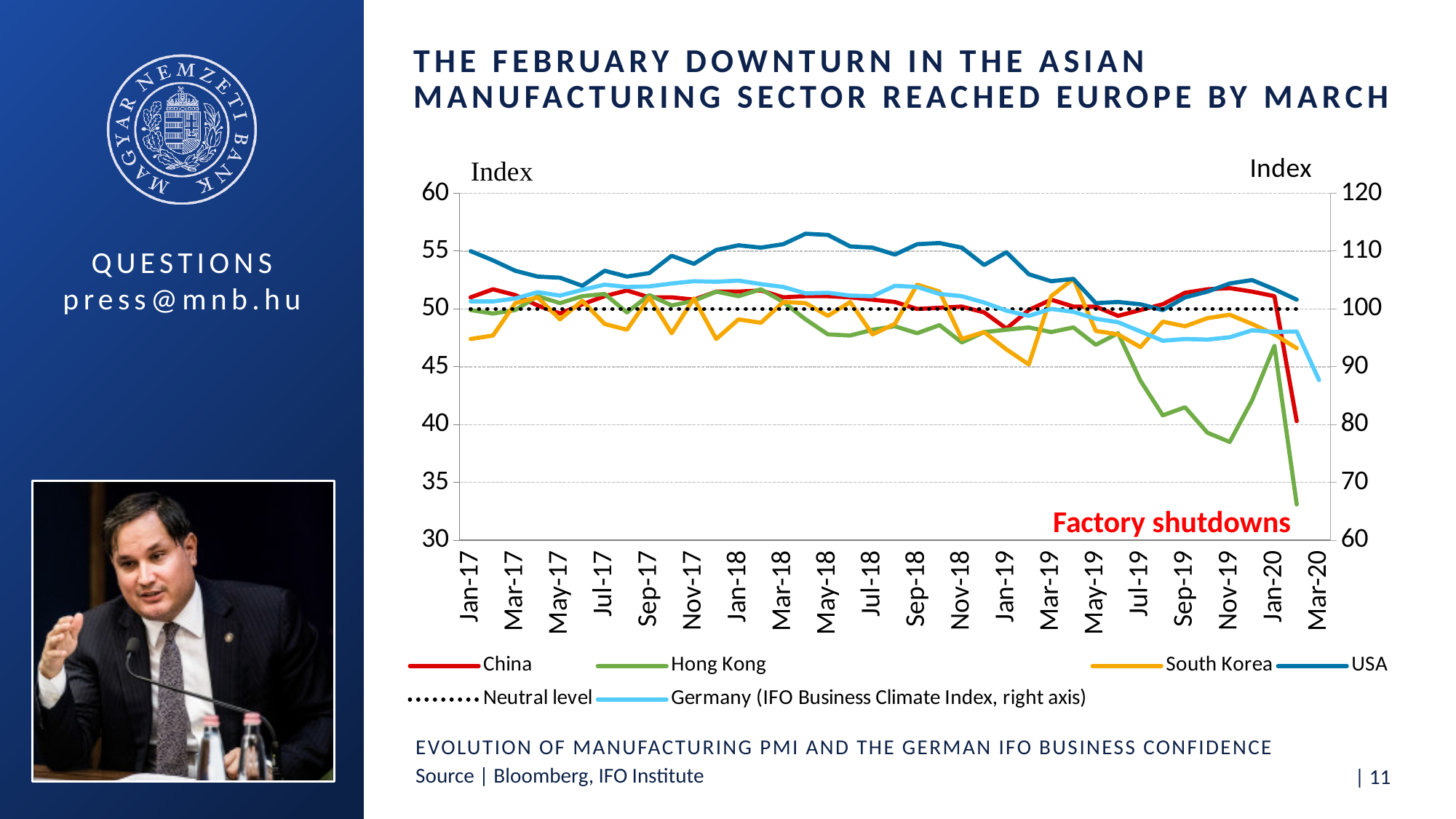
Is the value for South Korea in Jan-19 greater or less than 50? less How many series does the chart legend list? 6 Is the value for the USA in May-18 greater or less than 55? greater What kind of chart is shown on the slide? line chart Does the Hong Kong line rise or fall between Sep-18 and Nov-19? fall Which series in the legend is plotted on the right axis? Germany (IFO Business Climate Index, right axis) Among the left-axis series, which has the highest value in Jan-17? USA Is the value for Germany (right axis) at the last point (Mar-20) greater or less than 90? less At what level on the left axis is the Neutral level line drawn? 50